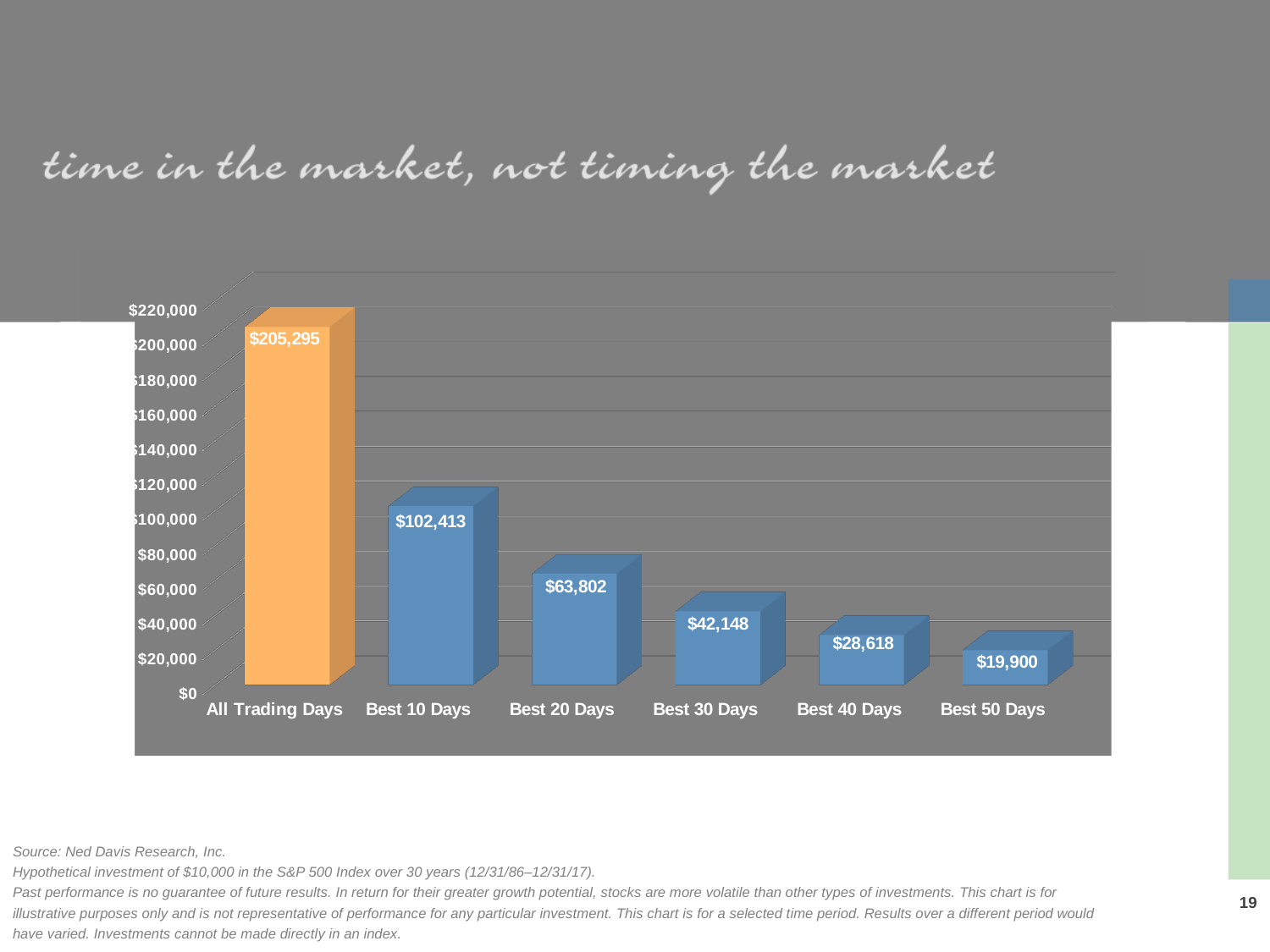
Which category has the lowest value? Best 50 Days What is the value for Best 50 Days? $19,900 Which is larger, the value for Best 10 Days or the value for Best 40 Days? Best 10 Days What kind of chart is shown on the slide? bar chart What is the value for Best 30 Days? $42,148 What is the difference between the values for Best 20 Days and Best 30 Days? $21,654 What is the value for All Trading Days? $205,295 What is the difference between the values for All Trading Days and Best 10 Days? $102,882 Is the value for Best 20 Days greater or less than $80,000? less Which category has the highest value? All Trading Days Do the values rise or fall moving from left to right along the x axis? fall How many categories are shown on the x axis? 6